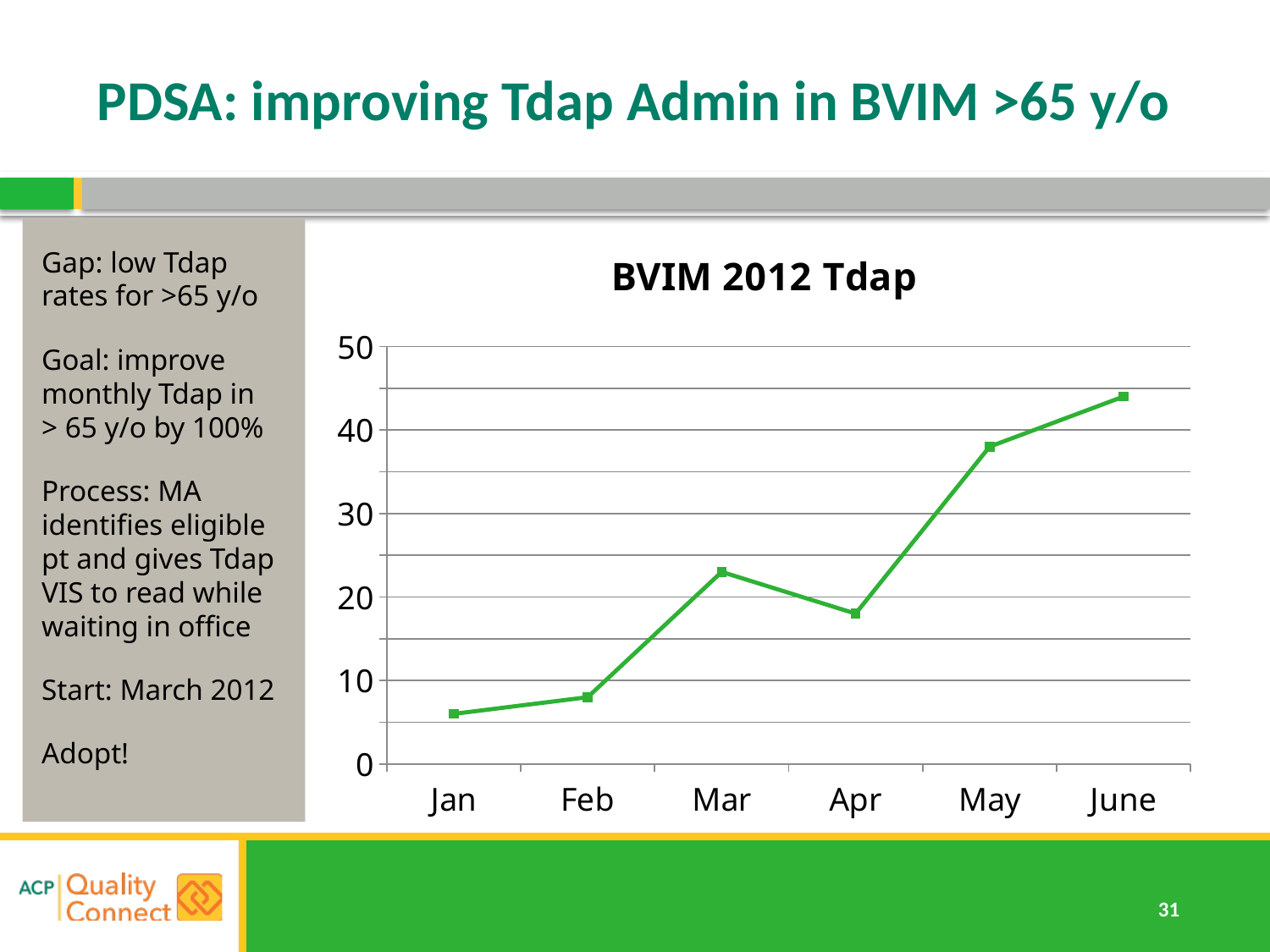
Is the value for Apr greater or less than 20? less Is the value for Jan greater or less than 10? less Is the value for June greater or less than 40? greater Overall, do the values rise or fall from Jan to June? rise Which month has the highest value in the chart? June How many months are plotted on the x axis of the chart? 6 Which is larger, the value for Mar or the value for Apr? Mar Which is larger, the value for May or the value for Feb? May Which month has the lowest value in the chart? Jan What kind of chart is shown on the slide? line chart What is the title of the chart? BVIM 2012 Tdap